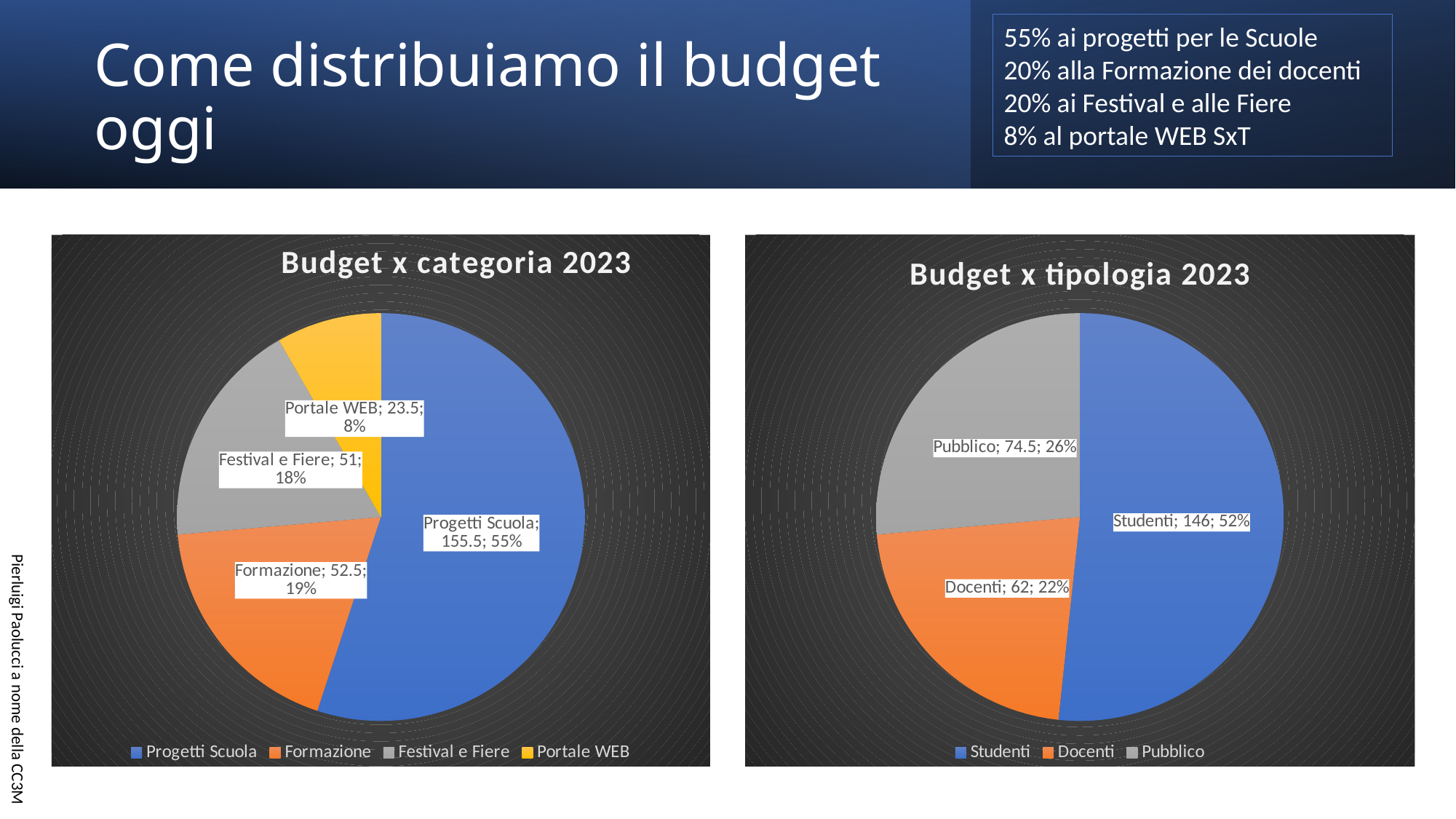
In the 'Budget x tipologia 2023' chart, what share of the pie does Studenti represent? 52% In the 'Budget x categoria 2023' chart, what is the difference between the values for Formazione and Festival e Fiere? 1.5 In the 'Budget x categoria 2023' chart, which category has the largest slice? Progetti Scuola In the 'Budget x categoria 2023' chart, which category has the smallest slice? Portale WEB In the 'Budget x tipologia 2023' chart, what is the difference between the values for Studenti and Pubblico? 71.5 In the 'Budget x categoria 2023' chart, what is the value for Progetti Scuola? 155.5 In the 'Budget x tipologia 2023' chart, what is the value for Docenti? 62 In the 'Budget x tipologia 2023' chart, what colour is the Docenti slice? Orange What kind of chart is 'Budget x tipologia 2023'? Pie chart In the 'Budget x categoria 2023' chart, what share of the pie does Portale WEB represent? 8% In the 'Budget x tipologia 2023' chart, which is larger, Pubblico or Docenti? Pubblico In the 'Budget x categoria 2023' chart, how many categories are shown? 4